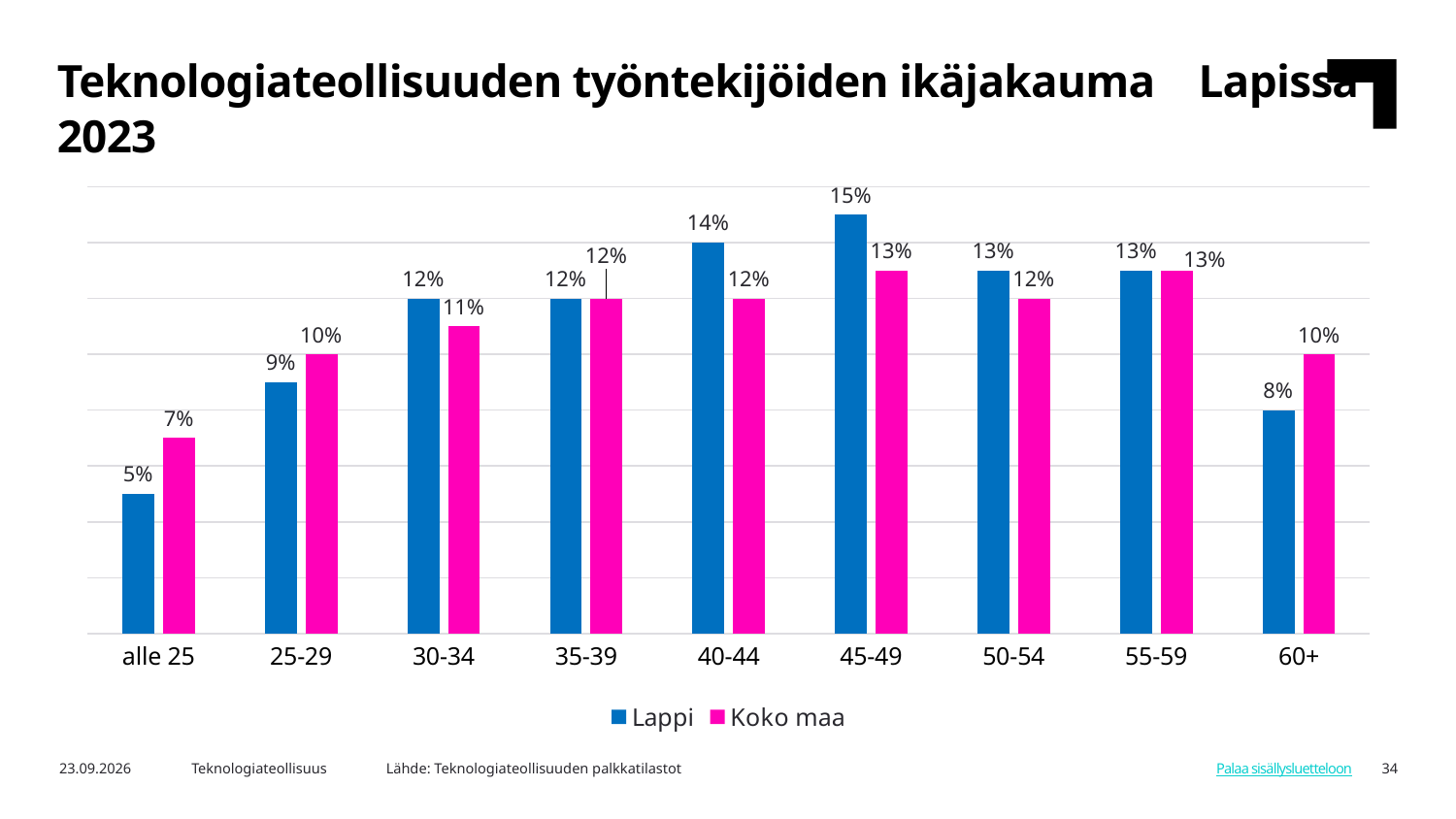
Which is larger in the 40-44 age group, Lappi or Koko maa? Lappi Which is larger in the 60+ age group, Lappi or Koko maa? Koko maa What is the value for Lappi in the 60+ age group? 8% How many series does the legend list? 2 What is the value for Lappi in the 45-49 age group? 15% What kind of chart is shown on the slide? Bar chart What is the value for Koko maa in the alle 25 age group? 7% What is the difference between Lappi and Koko maa in the 45-49 age group? 2 percentage points Which age group has the lowest value for Lappi? alle 25 Which age group has the highest value for Lappi? 45-49 How many age groups are shown on the x axis? 9 Which age group has the lowest value for Koko maa? alle 25